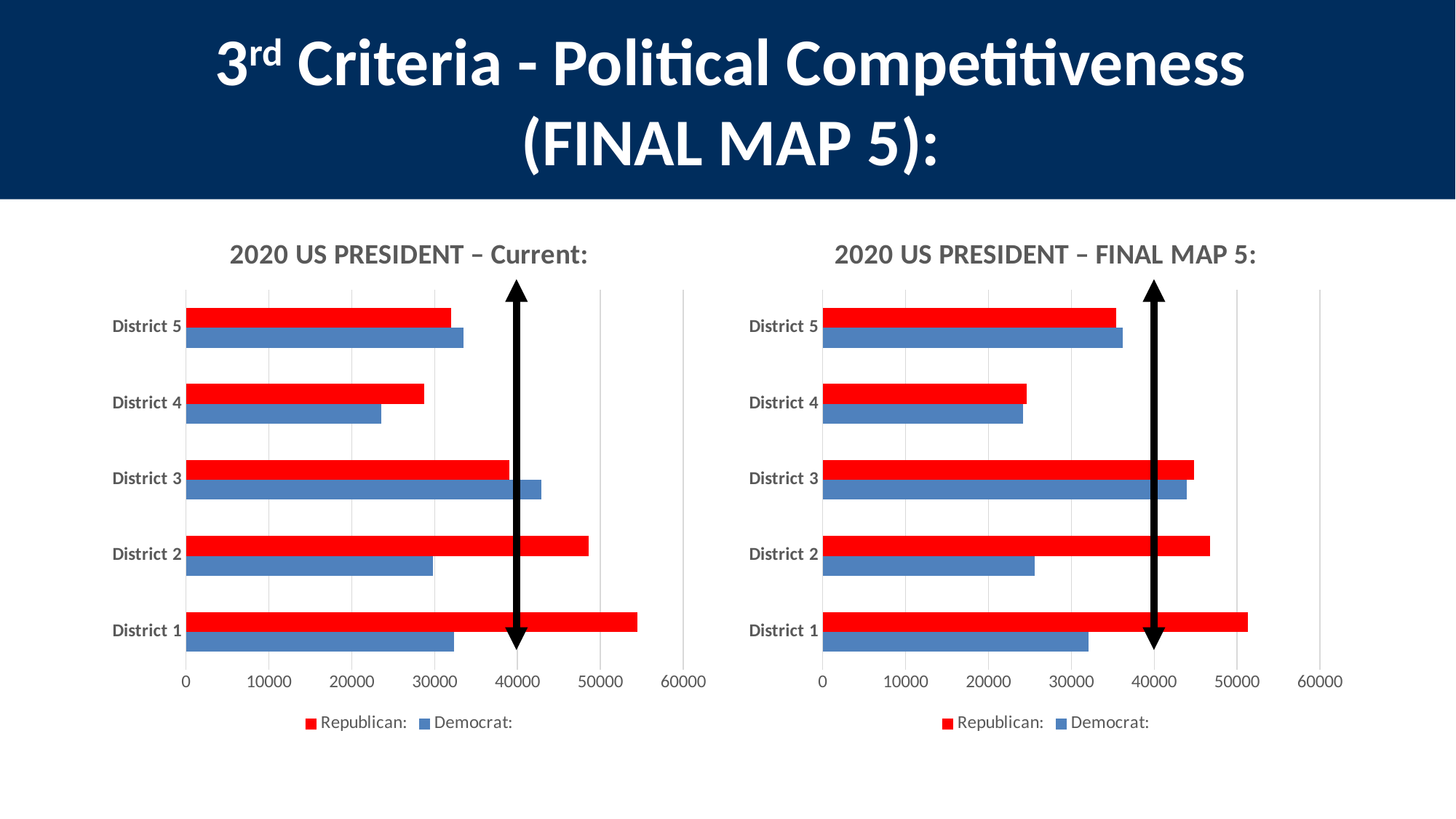
What kind of chart is the '2020 US PRESIDENT – Current:' chart? bar chart In the '2020 US PRESIDENT – Current:' chart, is the Republican value for District 1 greater or less than 50000? greater In the '2020 US PRESIDENT – FINAL MAP 5:' chart, which district has the highest Republican value? District 1 In the '2020 US PRESIDENT – FINAL MAP 5:' chart, is the Democrat value for District 2 greater or less than 30000? less In the '2020 US PRESIDENT – Current:' chart, which district has the lowest Democrat value? District 4 How many series does the legend of the '2020 US PRESIDENT – FINAL MAP 5:' chart list? 2 In the '2020 US PRESIDENT – Current:' chart, is the Democrat value for District 4 greater or less than 30000? less How many districts are shown in the '2020 US PRESIDENT – Current:' chart? 5 In the '2020 US PRESIDENT – Current:' chart, for District 2, which is larger: the Republican or the Democrat value? Republican In the '2020 US PRESIDENT – FINAL MAP 5:' chart, for District 2, which is larger: the Republican or the Democrat value? Republican In the '2020 US PRESIDENT – Current:' chart, which district has the highest Republican value? District 1